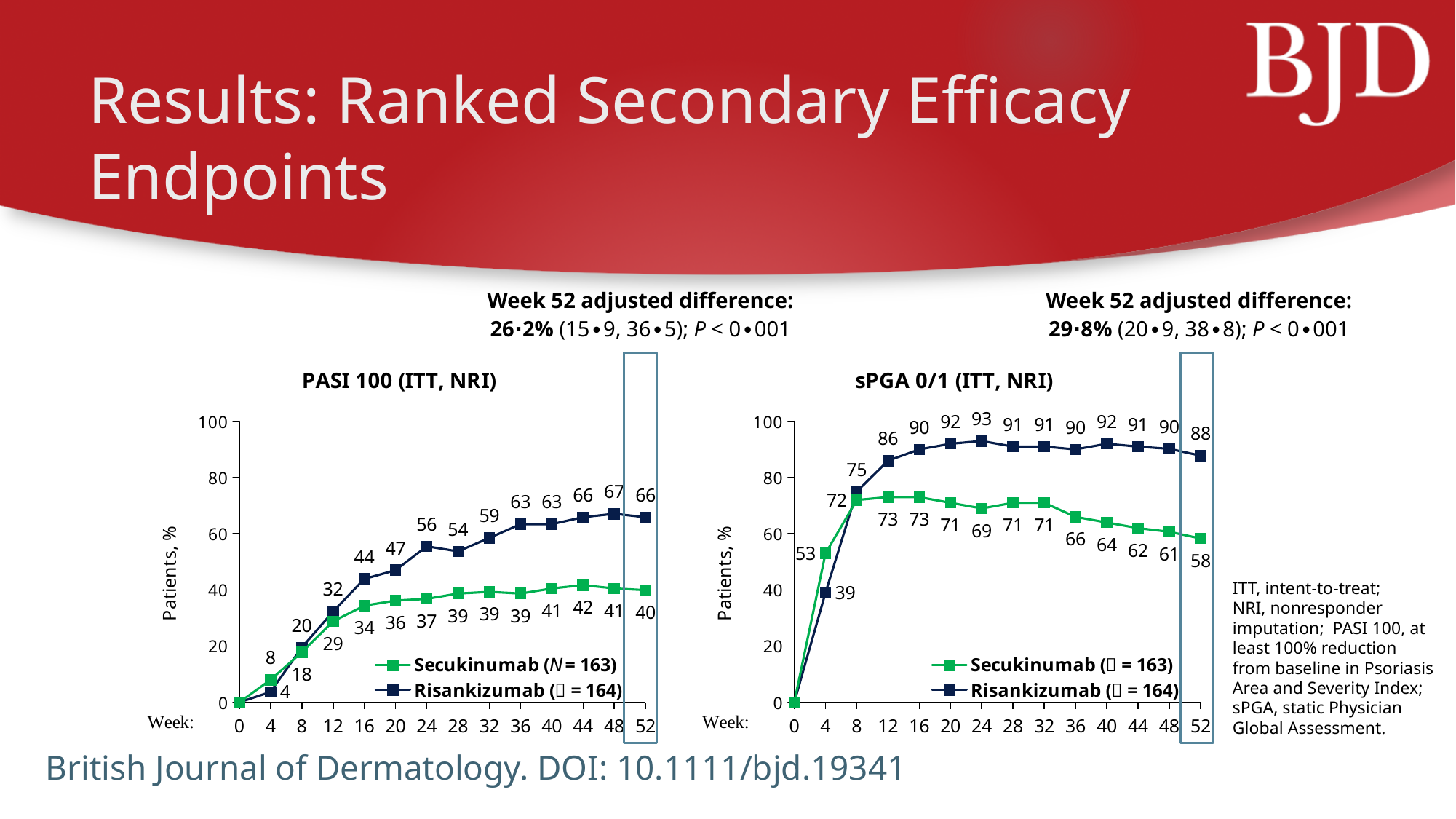
In the PASI 100 (ITT, NRI) chart, what is the value for Secukinumab at week 24? 37 In the PASI 100 (ITT, NRI) chart, what is the difference between Risankizumab and Secukinumab at week 52? 26 How many series does the legend of the PASI 100 (ITT, NRI) chart list? 2 In the PASI 100 (ITT, NRI) chart, what is the value for Risankizumab at week 52? 66 In the sPGA 0/1 (ITT, NRI) chart, does the Secukinumab line rise or fall between week 16 and week 52? fall In the sPGA 0/1 (ITT, NRI) chart, at which week does Secukinumab reach its highest value? 12 and 16 In the PASI 100 (ITT, NRI) chart, at which week does Risankizumab reach its highest value? 48 In the sPGA 0/1 (ITT, NRI) chart, what is the value for Secukinumab at week 52? 58 In the sPGA 0/1 (ITT, NRI) chart, what is the difference between Risankizumab and Secukinumab at week 4? 14 What kind of chart is the sPGA 0/1 (ITT, NRI) chart? line chart In the PASI 100 (ITT, NRI) chart, which series has the higher value at week 4, Secukinumab or Risankizumab? Secukinumab In the sPGA 0/1 (ITT, NRI) chart, what is the value for Risankizumab at week 24? 93